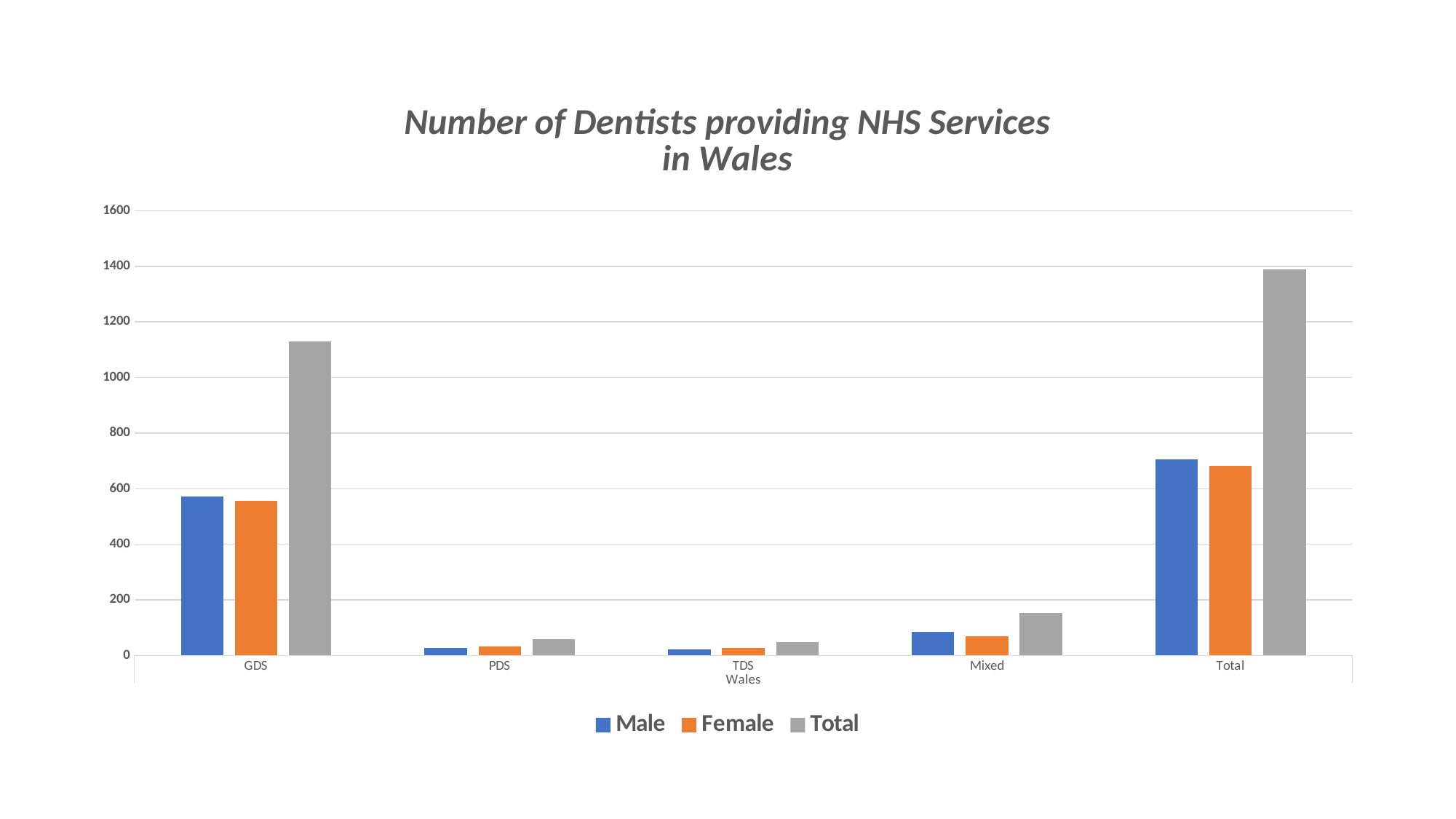
What kind of chart is shown on the slide? bar chart Among GDS, PDS, TDS and Mixed, which category has the highest Total series value? GDS Is the Total series value for GDS greater or less than 1000? greater How many categories are shown on the x axis? 5 Which colour represents the Female series in the legend? orange Which is larger, the Total series value for GDS or for Mixed? GDS Is the Total series value for the Total category greater or less than 1200? greater Is the Total series value for Mixed greater or less than 200? less What is the title of the chart? Number of Dentists providing NHS Services in Wales How many series does the legend list? 3